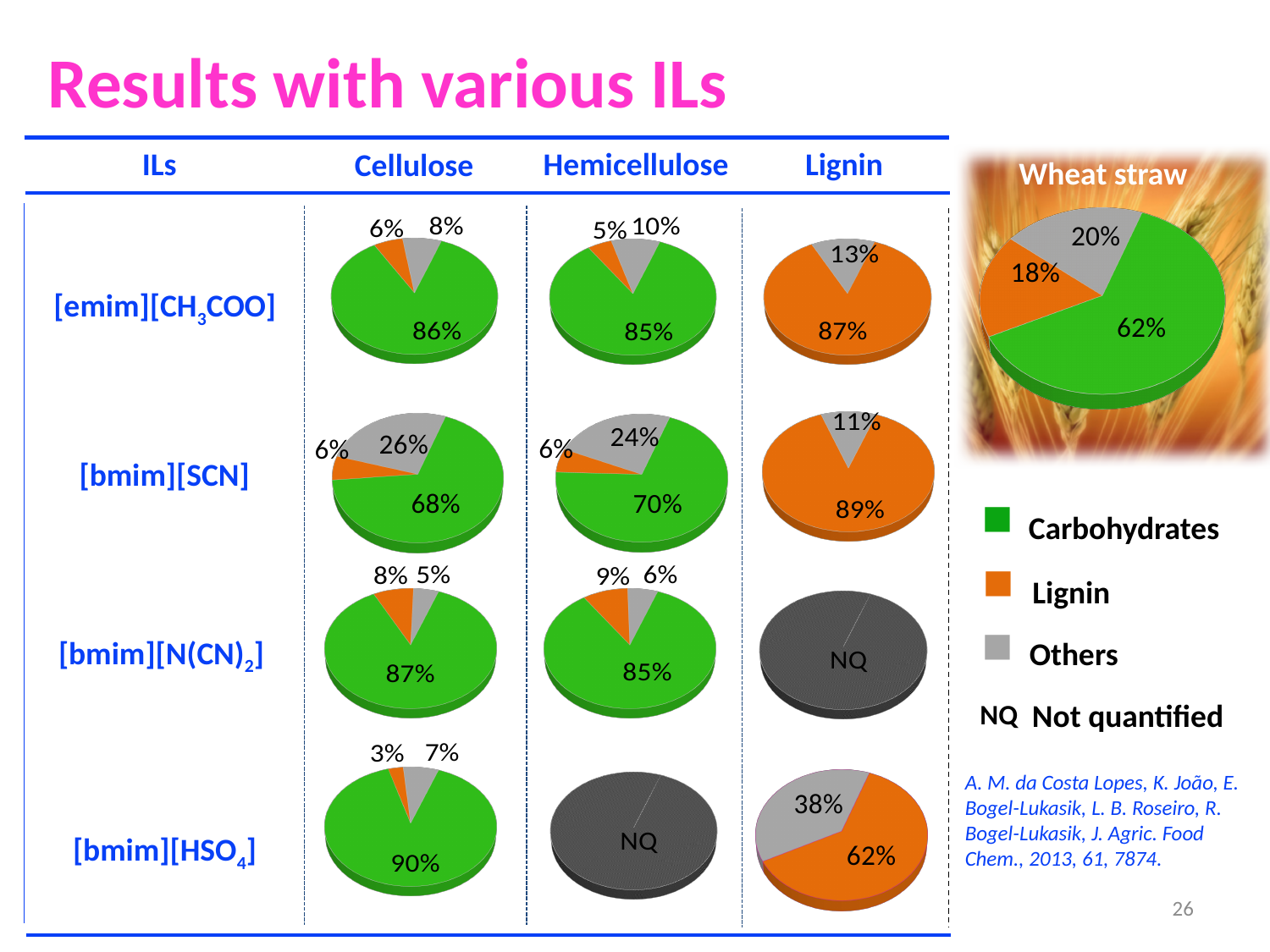
What type of chart is used on this slide? Pie chart How many entries does the legend list? 3 In the Lignin pie chart for [emim][CH3COO], which slice is larger, Lignin or Others? Lignin In the Wheat straw pie chart, what share is Lignin? 18% What is the difference between the Lignin share in the Lignin pie chart for [bmim][SCN] and for [emim][CH3COO]? 2% Which IL has the lowest Carbohydrates share in its Cellulose pie chart? [bmim][SCN] In the Cellulose pie chart for [bmim][HSO4], what share is Carbohydrates? 90% Which IL has the highest Carbohydrates share in its Cellulose pie chart? [bmim][HSO4] In the Cellulose pie chart for [bmim][SCN], what share is Others? 26%